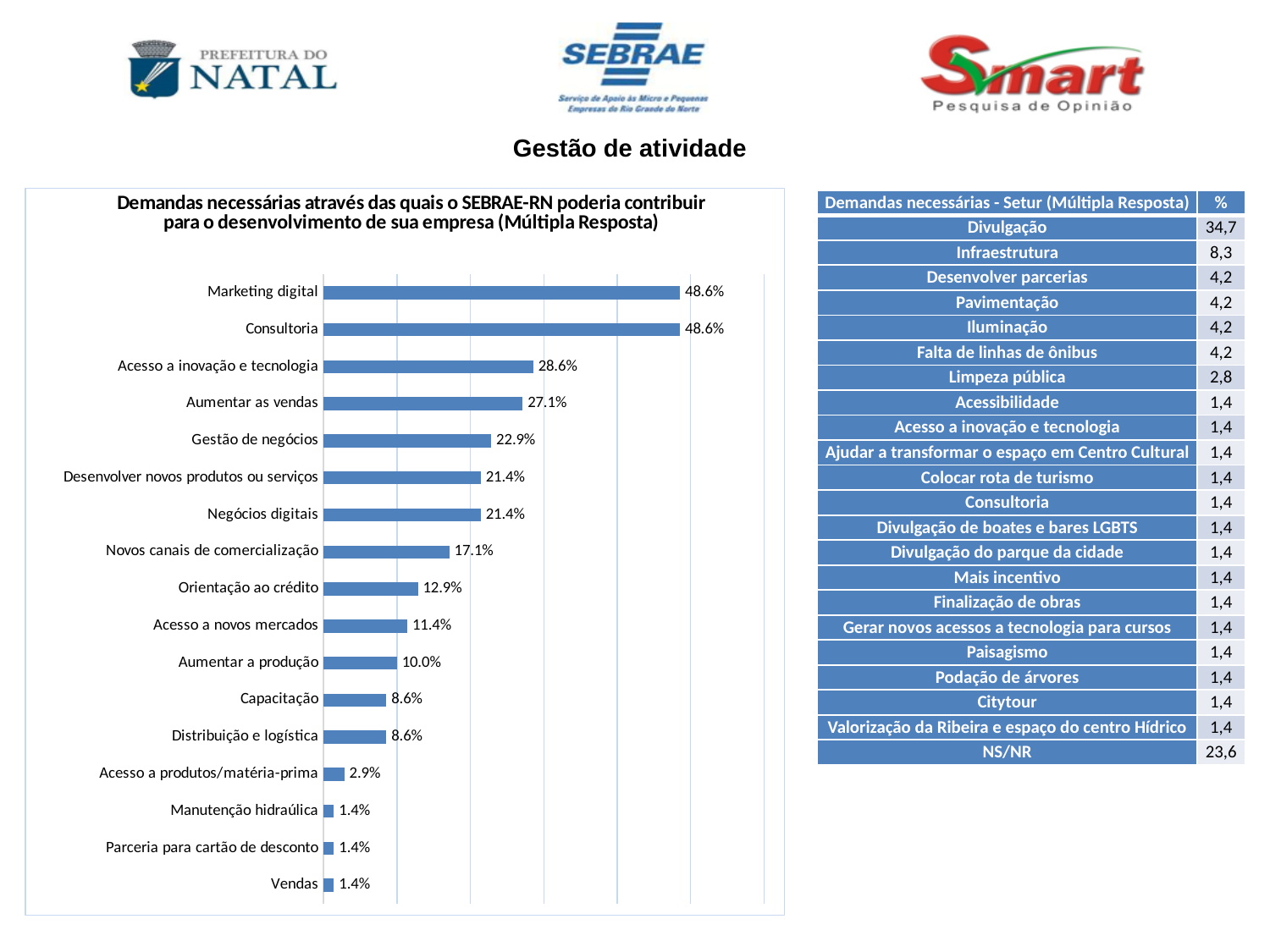
What is the value for Acesso a inovação e tecnologia? 28.6% What kind of chart is shown on the slide? Bar chart What is the value for Aumentar a produção? 10.0% What is the highest value shown in the chart? 48.6% What is the value for Orientação ao crédito? 12.9% How many categories are shown in the chart? 17 What is the difference between the values for Aumentar as vendas and Gestão de negócios? 4.2 percentage points What is the difference between the values for Marketing digital and Acesso a inovação e tecnologia? 20.0 percentage points What is the value for Marketing digital? 48.6% What is the value for Acesso a produtos/matéria-prima? 2.9% Which has a larger value, Novos canais de comercialização or Acesso a novos mercados? Novos canais de comercialização What is the title of the chart? Demandas necessárias através das quais o SEBRAE-RN poderia contribuir para o desenvolvimento de sua empresa (Múltipla Resposta)